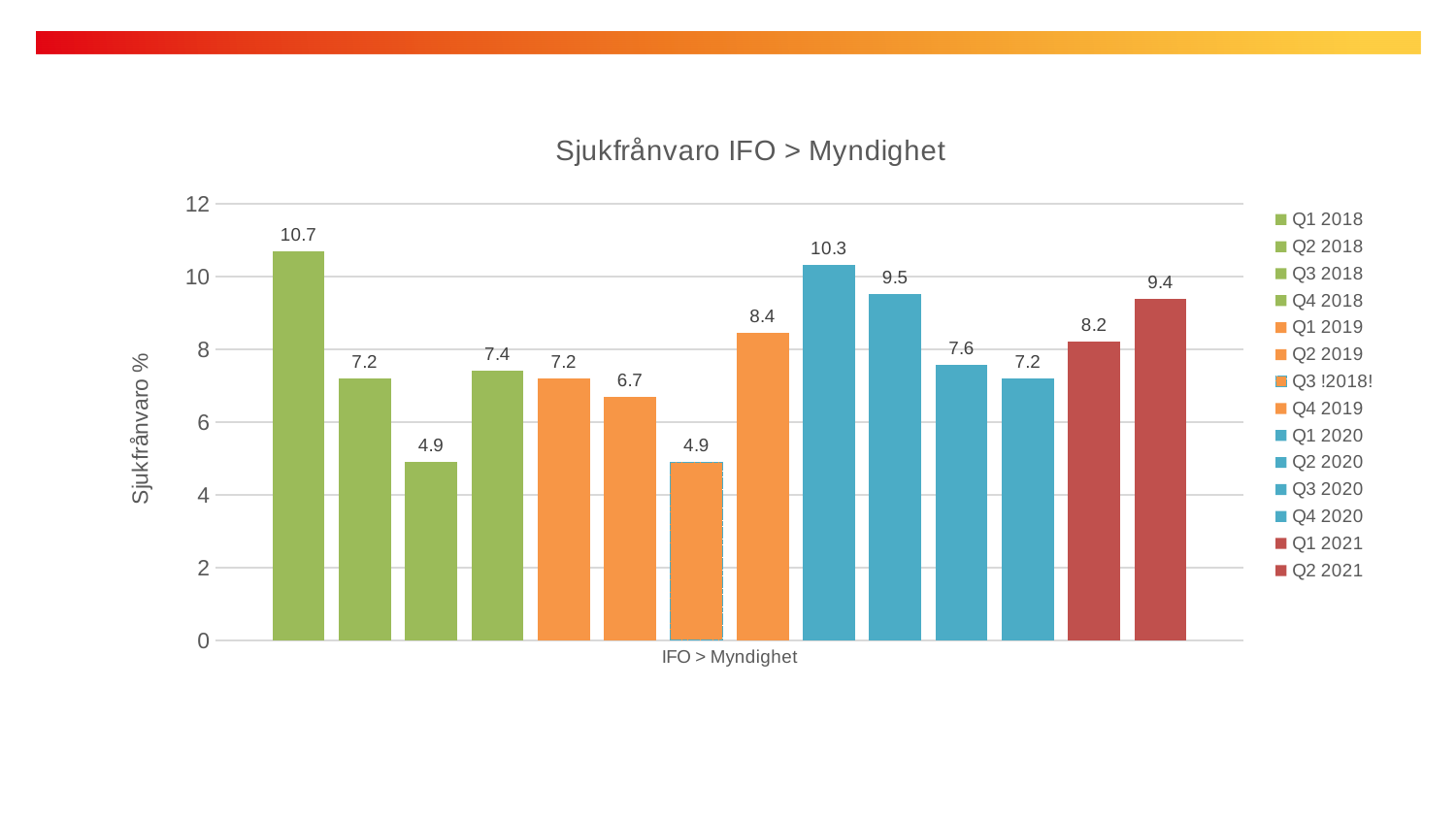
What is the difference between the values for Q1 2018 and Q1 2020? 0.4 What is the value for Q2 2021? 9.4 Which series has the highest value? Q1 2018 What is the lowest value shown on the chart? 4.9 How many bars are plotted on the chart? 14 What is the value for Q1 2018? 10.7 What is the difference between the values for Q2 2020 and Q3 2020? 1.9 Which is larger, the value for Q4 2019 or the value for Q1 2021? Q4 2019 How many entries does the legend list? 14 What is the title of the chart? Sjukfrånvaro IFO > Myndighet What is the value for Q1 2020? 10.3 What is the value for Q2 2019? 6.7